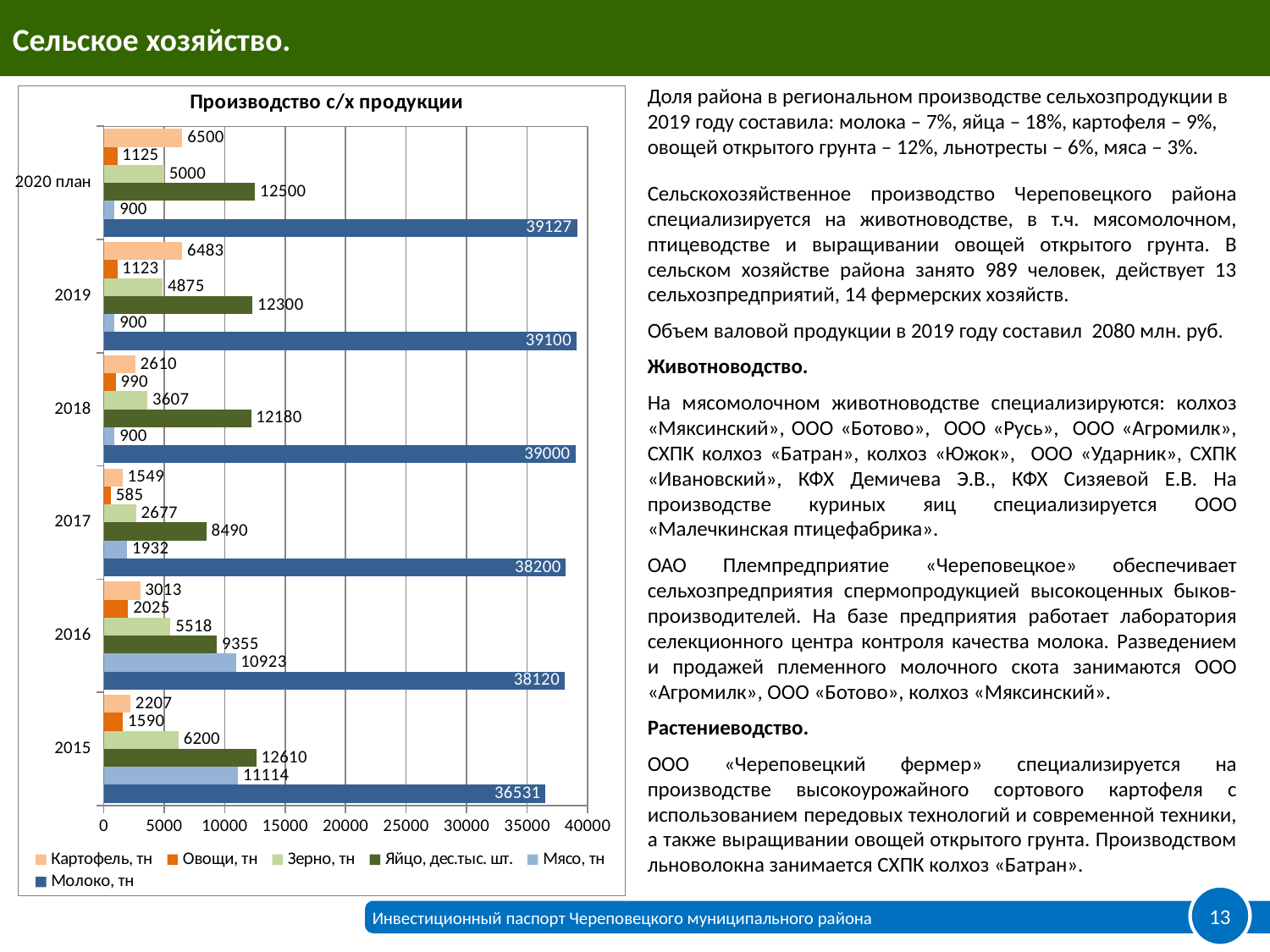
How many year categories are shown on the chart? 6 Which is larger: Зерно, тн in 2015 or Зерно, тн in 2016? 2015 What is the value of Яйцо, дес.тыс. шт. for 2015? 12610 What is the value of Мясо, тн for 2016? 10923 Does the value of Молоко, тн rise or fall from 2015 to 2020 план? rise What is the value of Картофель, тн for 2020 план? 6500 What is the value of Молоко, тн for 2019? 39100 In which year is the value of Молоко, тн the lowest? 2015 How many series does the legend of the chart list? 6 What is the difference between Молоко, тн in 2020 план and in 2019? 27 What type of chart is shown on the slide? bar chart In which year is the value of Овощи, тн the lowest? 2017